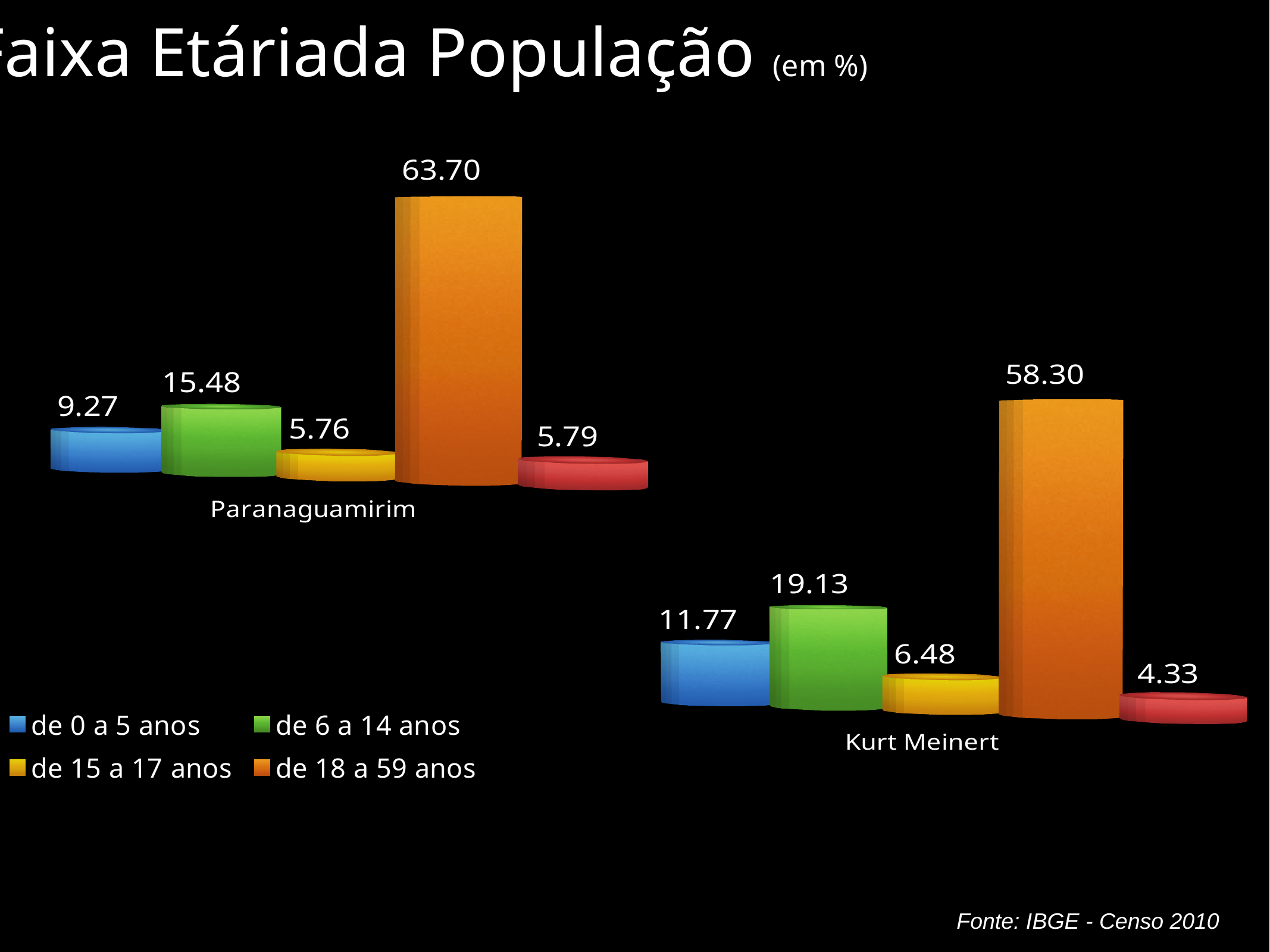
In Paranaguamirim, which is larger: 'de 0 a 5 anos' or 'de 15 a 17 anos'? de 0 a 5 anos What is the value for 'de 0 a 5 anos' in Kurt Meinert? 11.77 What is the value for 'de 6 a 14 anos' in Paranaguamirim? 15.48 What is the difference between the 'de 18 a 59 anos' values for Paranaguamirim and Kurt Meinert? 5.40 What is the value for 'de 18 a 59 anos' in Paranaguamirim? 63.70 How many neighbourhoods (categories) are shown on the x axis? 2 What kind of chart is shown on the slide? Bar chart Which neighbourhood has the larger value for 'de 6 a 14 anos', Paranaguamirim or Kurt Meinert? Kurt Meinert What is the value for 'de 15 a 17 anos' in Kurt Meinert? 6.48 How much larger is the 'de 6 a 14 anos' value in Kurt Meinert than in Paranaguamirim? 3.65 How many series does the legend list? 4 Which age group has the highest value in Kurt Meinert? de 18 a 59 anos